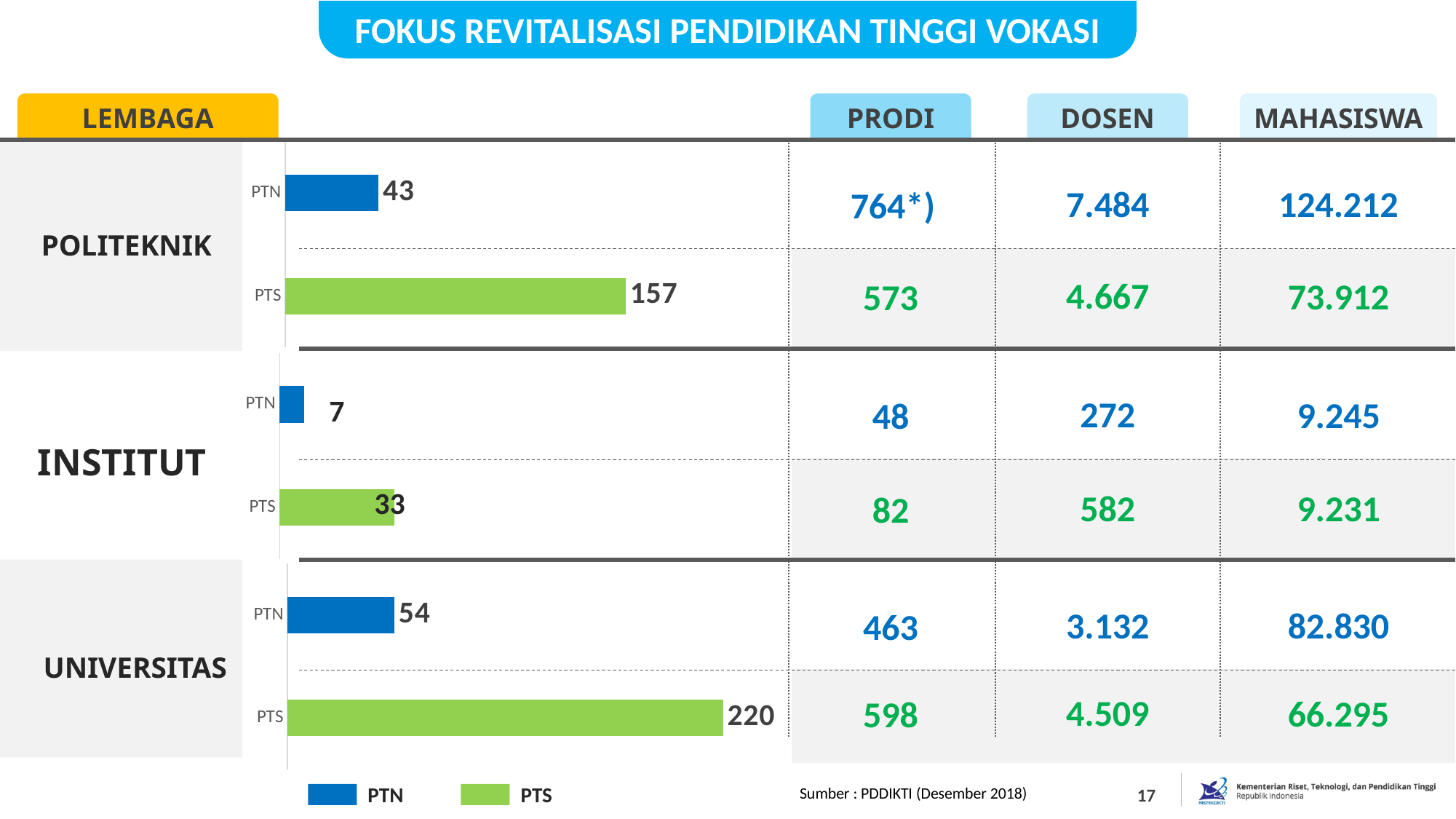
In the POLITEKNIK bar chart, what is the difference between the PTS and PTN values? 114 In the INSTITUT bar chart, what is the value for PTN? 7 In the POLITEKNIK bar chart, what is the value for PTS? 157 In the UNIVERSITAS bar chart, what is the value for PTN? 54 In the UNIVERSITAS bar chart, what is the value for PTS? 220 What kind of chart is used to show the PTN and PTS values for each institution type? Bar chart In the UNIVERSITAS bar chart, what is the difference between the PTS and PTN values? 166 How many series does the legend at the bottom of the slide list? 2 What colour are the PTS bars in the charts? Green In the INSTITUT bar chart, which is larger, PTN or PTS? PTS In the INSTITUT bar chart, what is the value for PTS? 33 In the POLITEKNIK bar chart, what is the value for PTN? 43